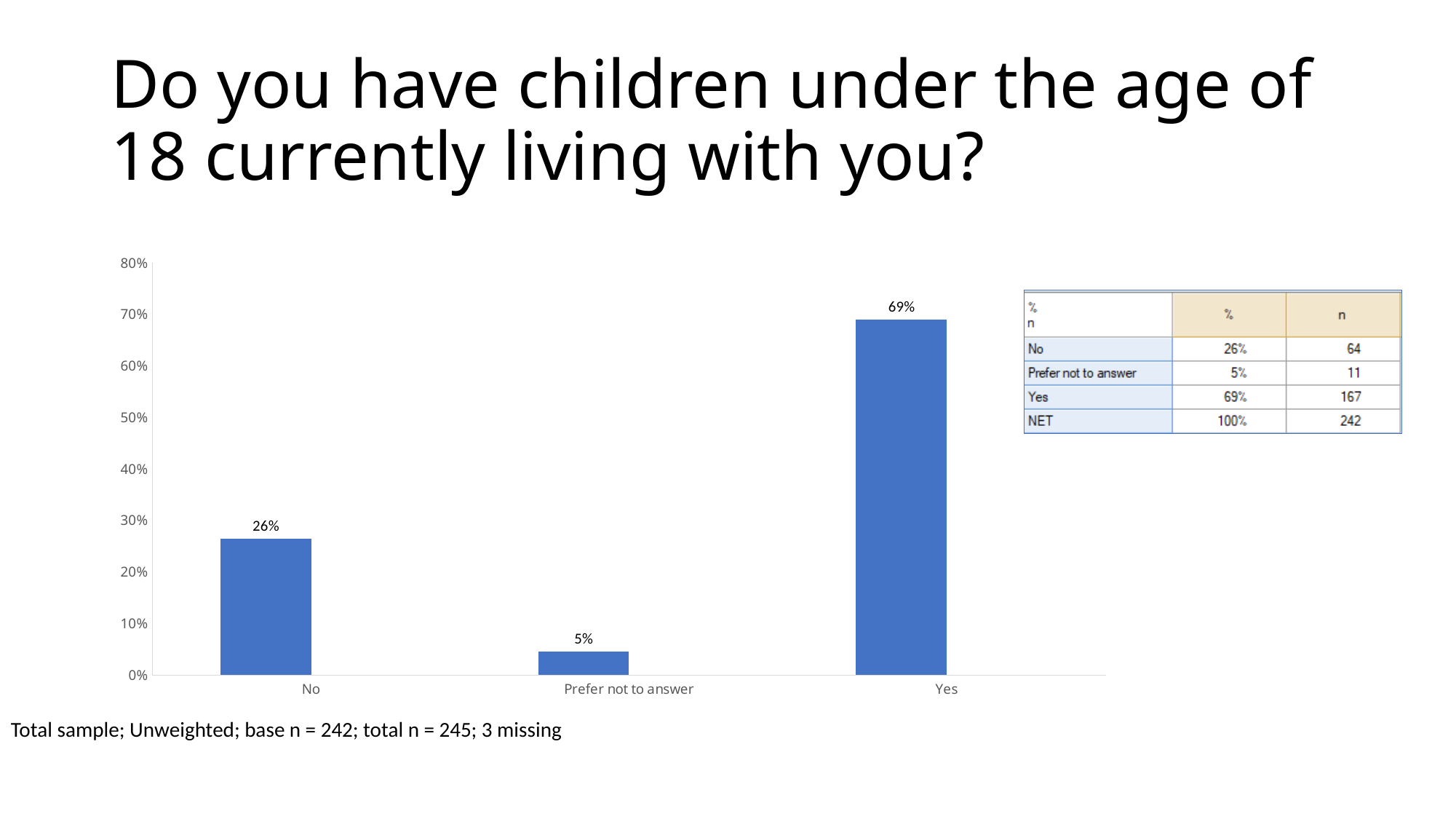
What is the difference in percentage points between "No" and "Prefer not to answer"? 21 How many response categories are shown on the x axis? 3 Which response category has the highest percentage? Yes Which is larger, the percentage for "No" or for "Prefer not to answer"? No What percentage of respondents answered "No"? 26% Which response category has the lowest percentage? Prefer not to answer What percentage of respondents answered "Yes"? 69% What percentage of respondents chose "Prefer not to answer"? 5% Is the value for "Yes" greater or less than 60%? greater What kind of chart is shown on the slide? Bar chart What is the highest value shown on the y axis? 80% What is the difference in percentage points between "Yes" and "No"? 43